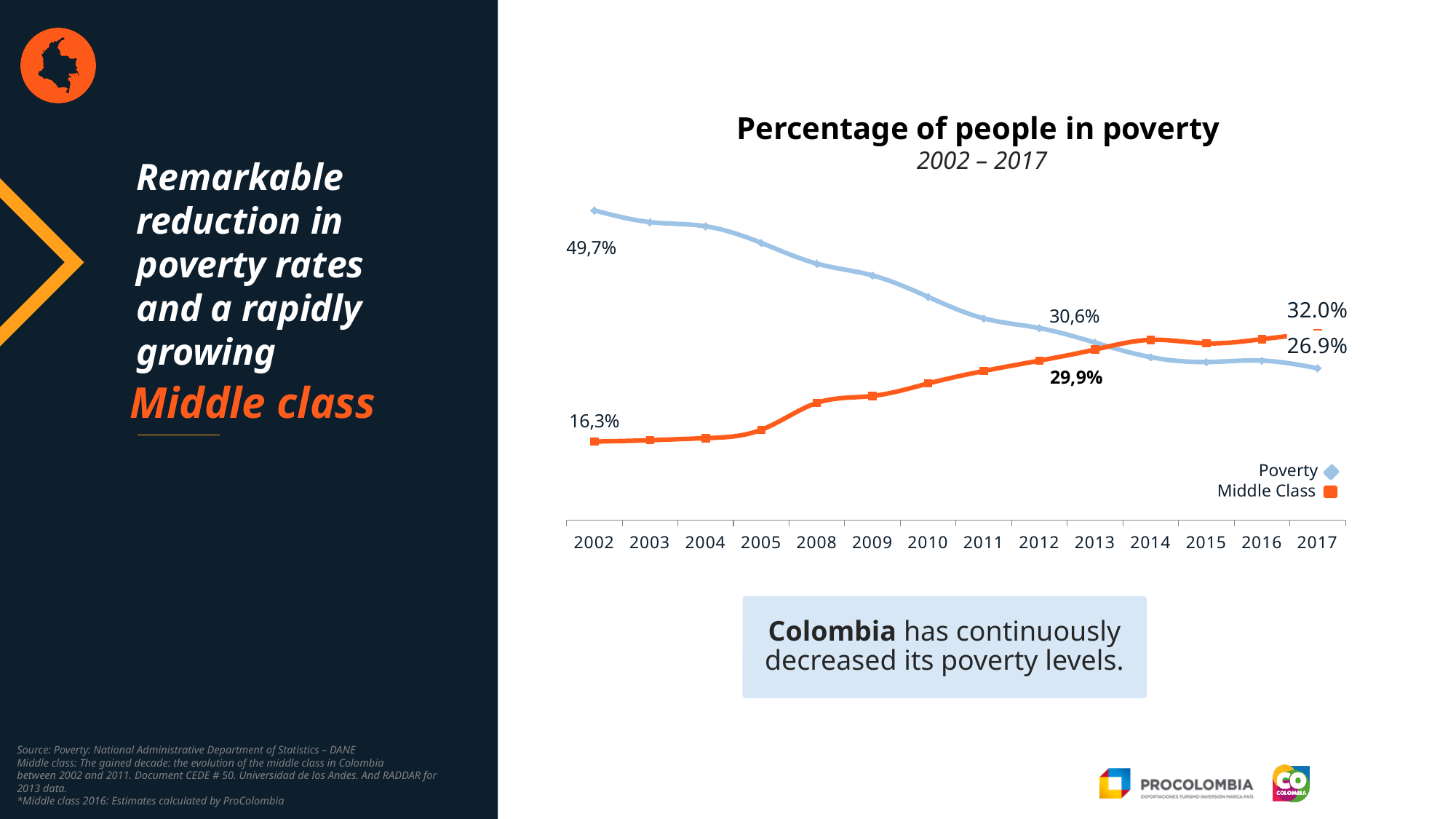
How many years are shown on the x axis? 14 What is the poverty rate shown for 2002? 49,7% How many series does the legend list? 2 In 2012, which series has the higher value, Poverty or Middle Class? Poverty In 2017, which series has the higher value, Poverty or Middle Class? Middle Class What is the Middle Class value shown for 2017? 32.0% Does the Poverty line rise or fall from 2002 to 2017? Fall What is the Middle Class value shown for 2002? 16,3% What is the Poverty value shown for 2017? 26.9%